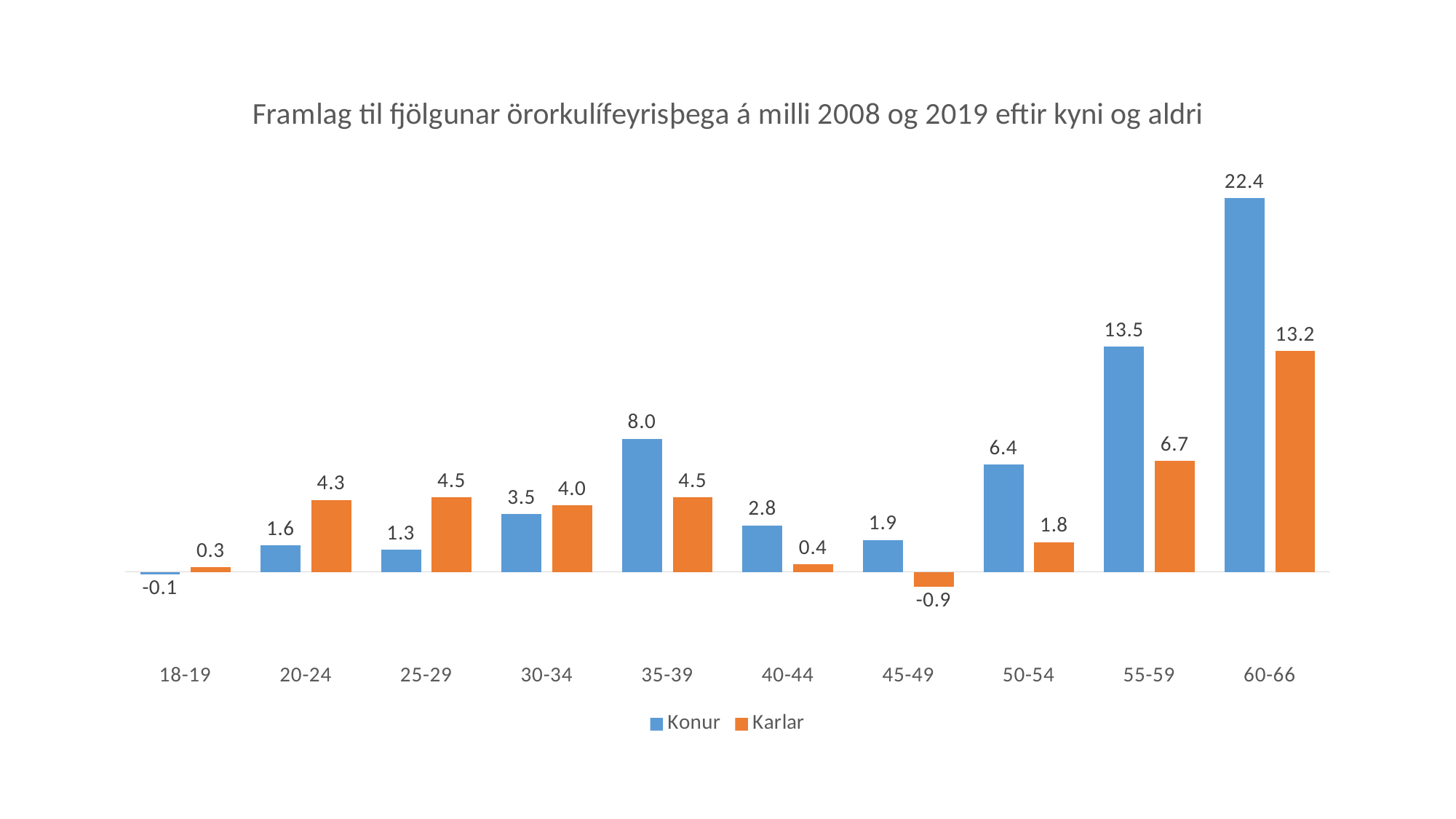
What is the difference between the Konur values for 55-59 and 50-54? 7.1 Which is larger in the 25-29 age group, Konur or Karlar? Karlar What is the difference between the Konur and Karlar values in the 60-66 age group? 9.2 Which age group has the lowest value for Karlar? 45-49 What colour are the Karlar bars? Orange Which age group has the highest value for Konur? 60-66 What is the value for Karlar in the 45-49 age group? -0.9 What is the value for Konur in the 35-39 age group? 8.0 What is the value for Konur in the 18-19 age group? -0.1 What kind of chart is shown on the slide? Bar chart How many series does the legend list? 2 How many age groups are shown on the x axis? 10